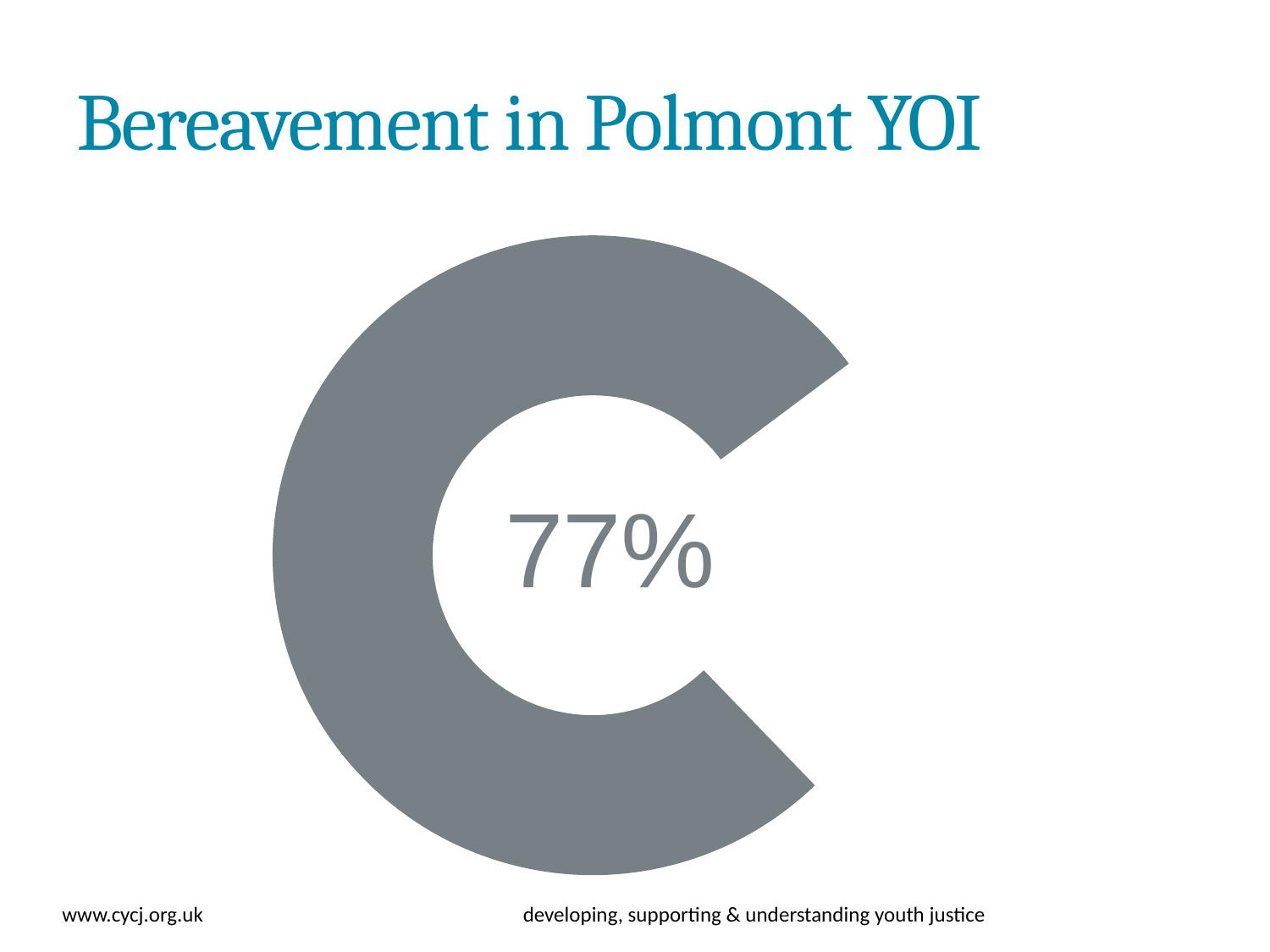
What is the title of the slide containing the doughnut chart? Bereavement in Polmont YOI What kind of chart is shown on the slide? Doughnut chart Is the value shown in the doughnut chart greater or less than 50%? greater What percentage is printed in the centre of the doughnut chart? 77% Is the value shown in the doughnut chart greater or less than 80%? less What share of the doughnut chart does the grey segment represent? 77% What colour is the filled segment of the doughnut chart? Grey How many filled segments does the doughnut chart have? 1 What percentage of the doughnut chart is left unfilled by the grey segment? 23%